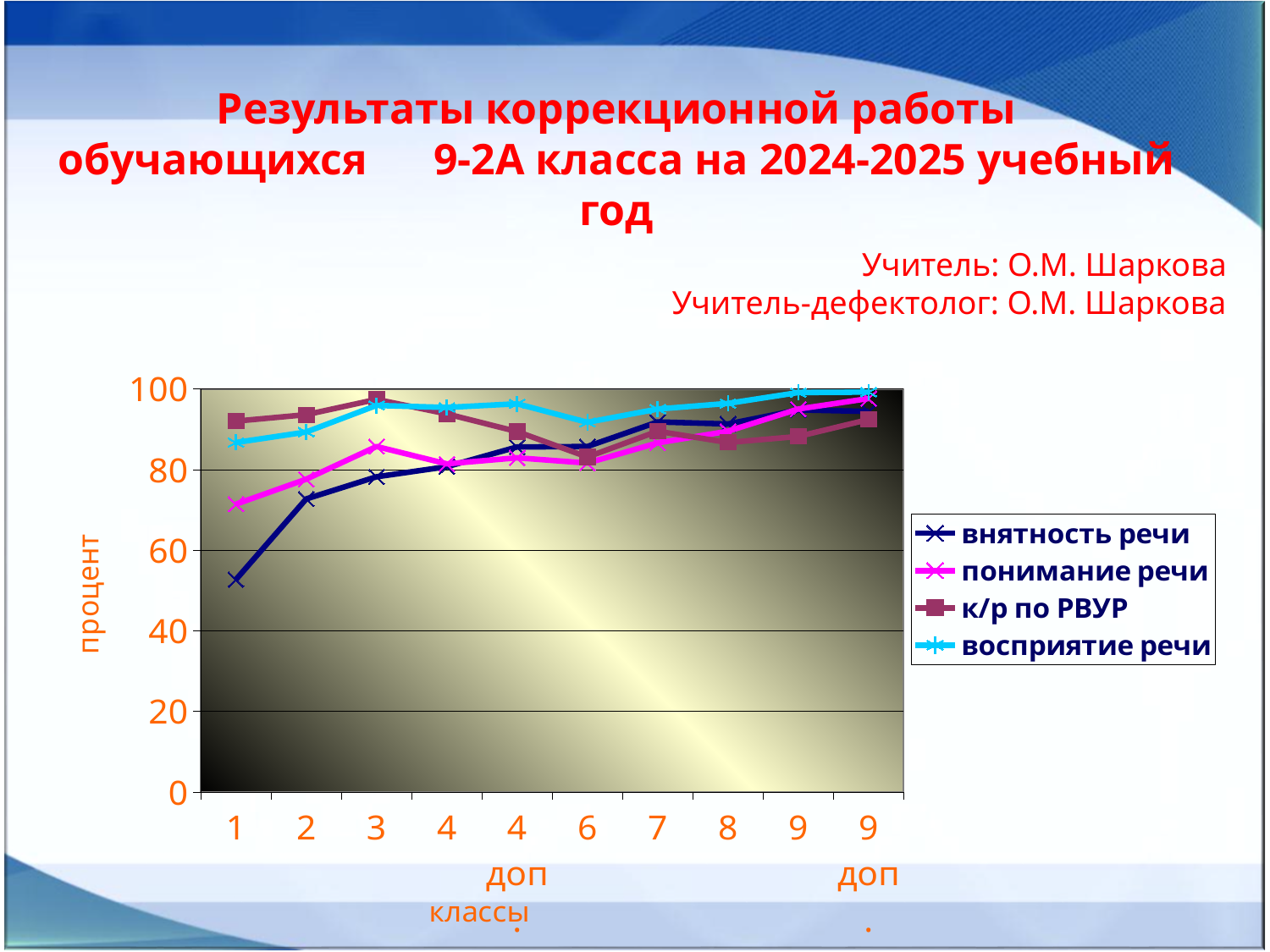
Do the values for внятность речи generally rise or fall from category 1 to category 9 доп? rise Which legend entry is drawn in light blue? восприятие речи How many series does the legend list? 4 Is the value for восприятие речи at category 9 доп greater or less than 80? greater At category 1, which is larger: к/р по РВУР or внятность речи? к/р по РВУР Is the value for к/р по РВУР at category 1 greater or less than 80? greater Is the value for понимание речи at category 1 greater or less than 80? less What is the title of the vertical axis? процент What kind of chart is shown on the slide? line chart How many points are plotted along the x axis for each series? 10 Which series has the lowest value at category 1? внятность речи